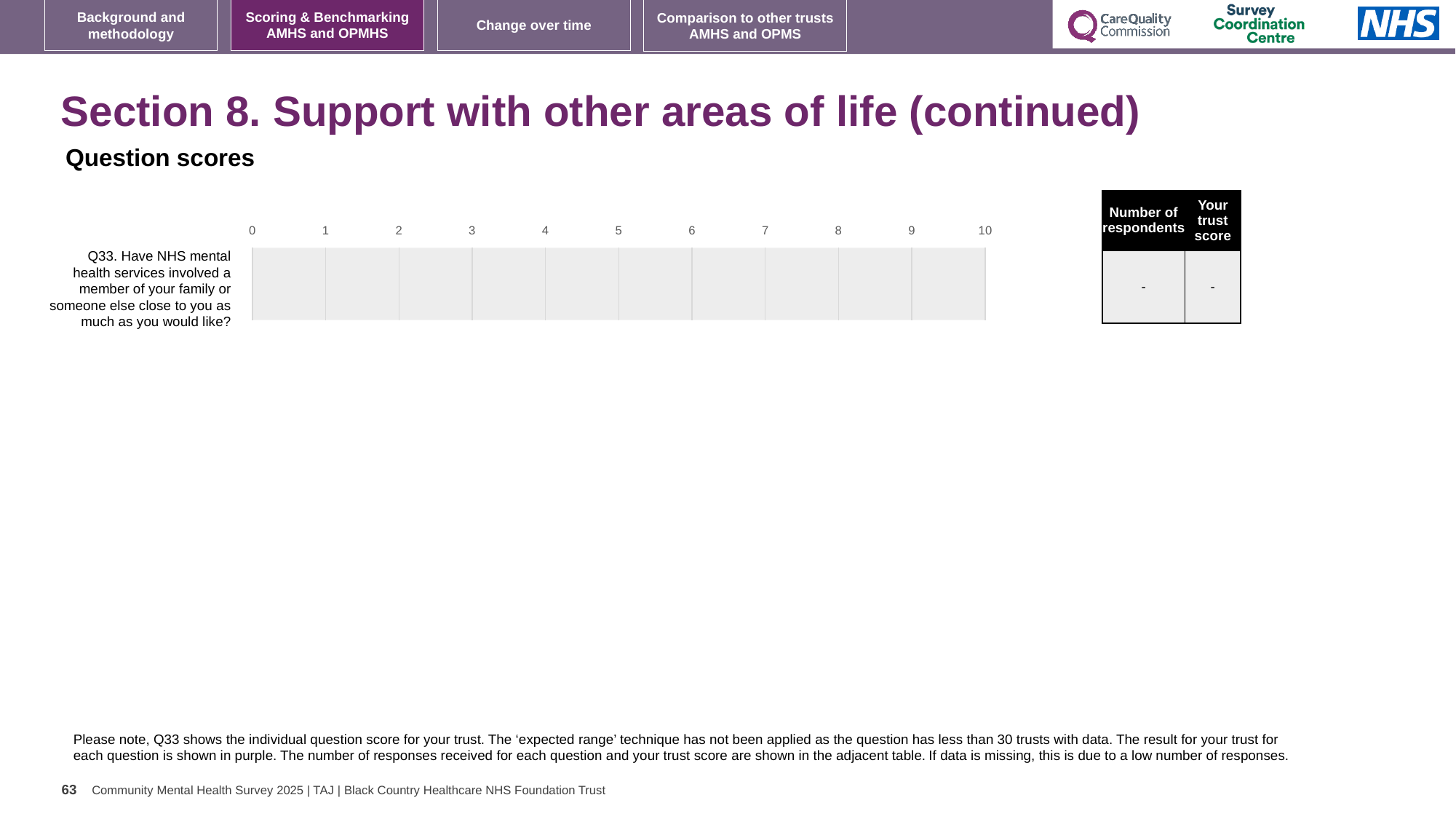
Which question number is plotted on the chart? Q33 How many questions (categories) are listed on the chart? 1 What is the highest value shown on the chart's axis? 10 What kind of chart is shown on the slide? bar chart What is the 'Number of respondents' value shown in the table for Q33? - What is the 'Your trust score' value shown in the table for Q33? -